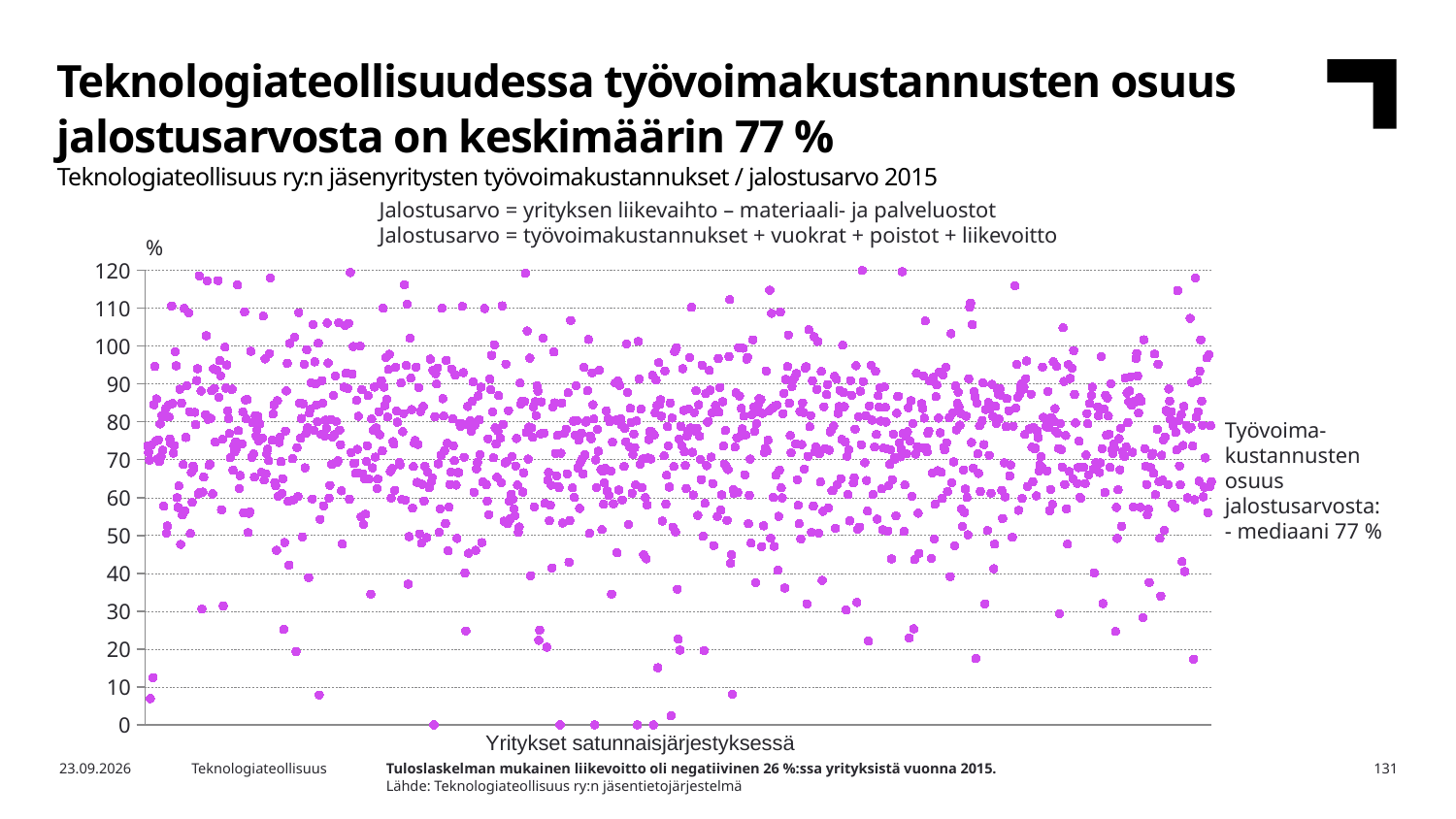
According to the annotation next to the chart, what is the median share of labour costs in value added? 77 % What is the label of the chart's x axis? Yritykset satunnaisjärjestyksessä What kind of chart is shown on the slide? scatter chart What is the highest tick value shown on the chart's y axis? 120